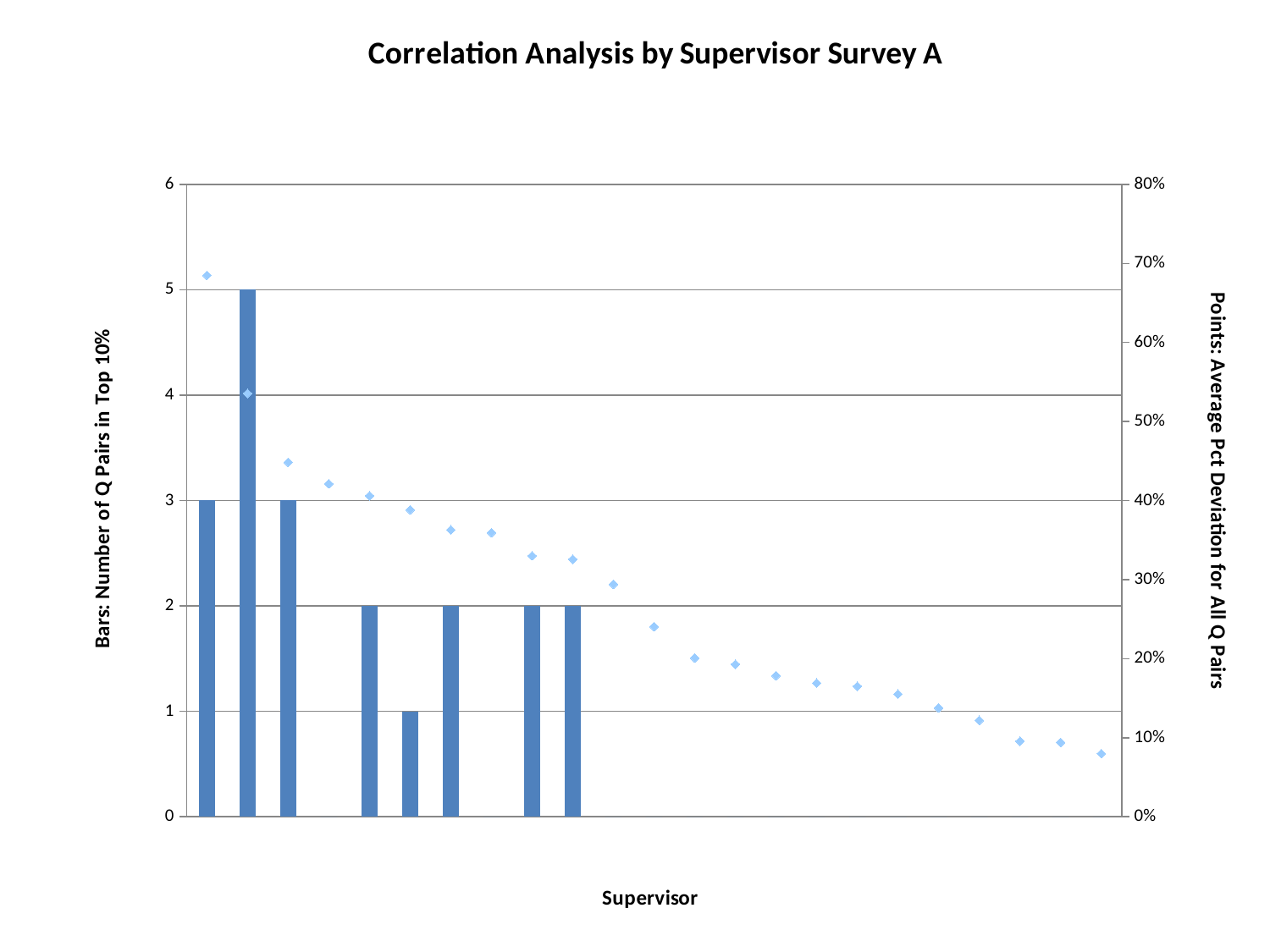
What is the value of the tallest bar on the left axis? 5 Is the value of the leftmost point greater or less than 60% on the right axis? greater Which is larger, the first bar from the left or the second bar from the left? The second bar What is the value of the second bar from the left? 5 How many bars have a value of 2? 4 What is the value of the shortest bar on the left axis? 1 Do the plotted points rise or fall from left to right along the x axis? Fall What is the label of the left vertical axis? Bars: Number of Q Pairs in Top 10% What kind of chart is this? Combination bar and scatter (points) chart Is the value of the rightmost point greater or less than 10% on the right axis? less How many bars are plotted on the chart? 8 What is the title of the chart? Correlation Analysis by Supervisor Survey A